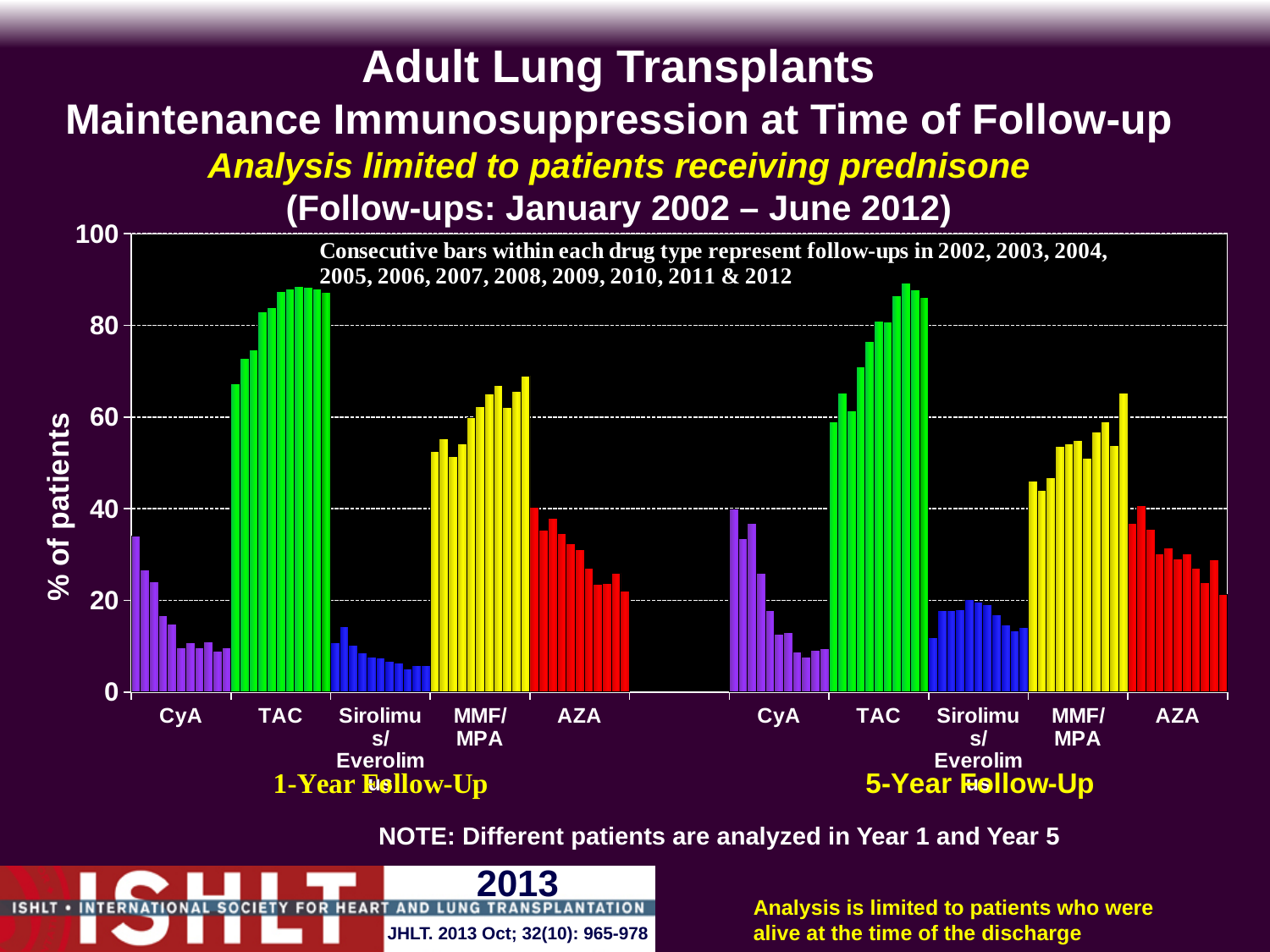
In the 5-Year Follow-Up chart, which is larger in 2012: the value for MMF/MPA or the value for AZA? MMF/MPA What is the label on the y axis of the chart? % of patients In the 5-Year Follow-Up chart, do the TAC bars rise or fall from 2002 to 2012? Rise In the 1-Year Follow-Up chart, which drug type has the highest bars? TAC In the 1-Year Follow-Up chart, is the value for TAC in 2012 greater or less than 80? greater In the 1-Year Follow-Up chart, is the value for CyA in 2002 greater or less than 40? less In the 1-Year Follow-Up chart, do the CyA bars rise or fall from 2002 to 2012? Fall In the 5-Year Follow-Up chart, which drug type has the lowest bars? Sirolimus/Everolimus According to the note on the chart, how many consecutive bars are there within each drug type? 11 In the 1-Year Follow-Up chart, how many drug types are shown on the x axis? 5 In the 5-Year Follow-Up chart, is the value for MMF/MPA in 2012 greater or less than 60? greater What kind of chart is shown on the slide? Bar chart